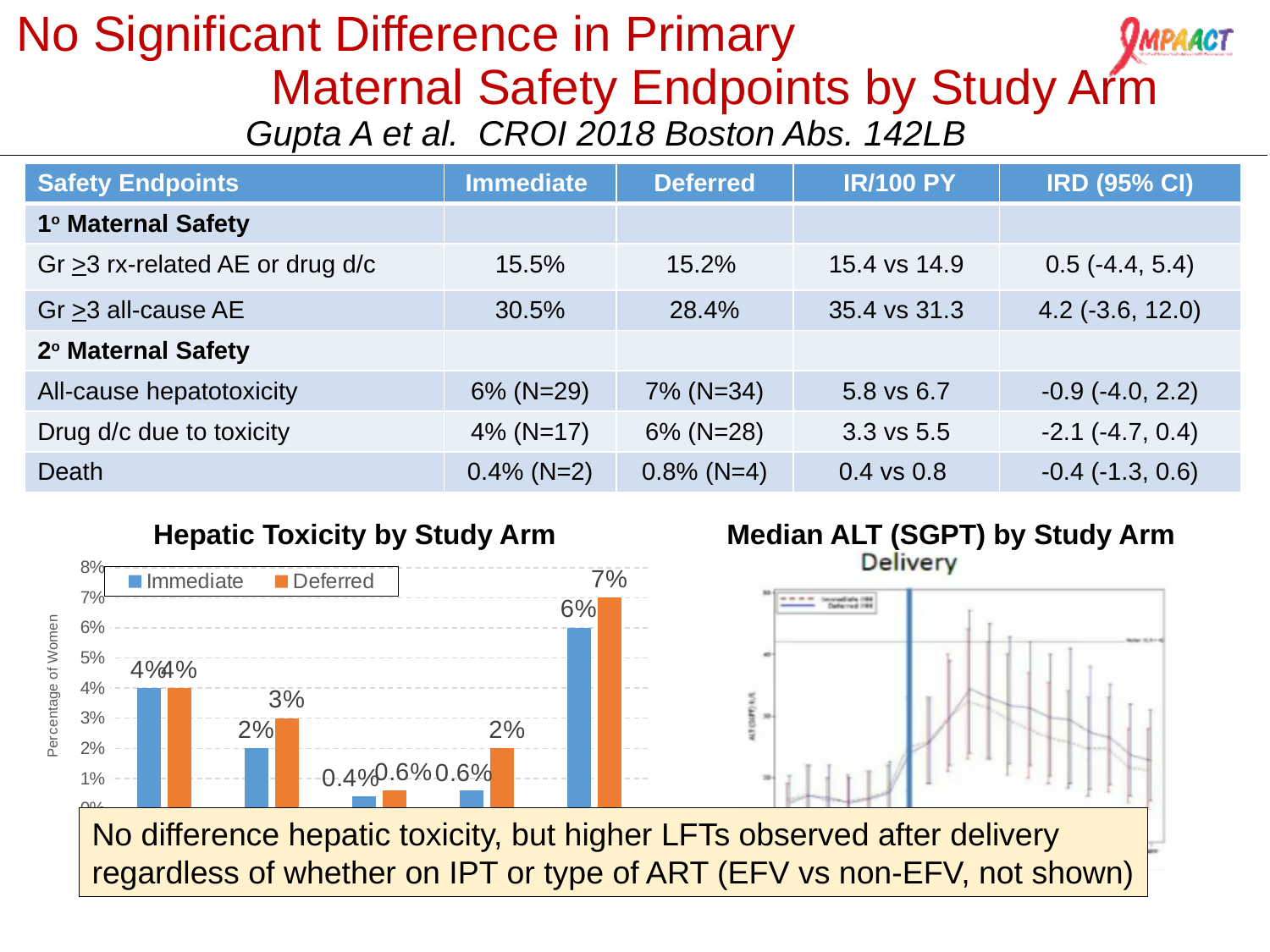
In the Hepatic Toxicity by Study Arm chart, which series has the tallest bar? Deferred In the rightmost group of the Hepatic Toxicity by Study Arm chart, which is larger, Immediate or Deferred? Deferred In the Hepatic Toxicity by Study Arm chart, what is the Deferred value in the rightmost group of bars? 7% What kind of chart is the Hepatic Toxicity by Study Arm chart? bar chart What is the y-axis label of the Hepatic Toxicity by Study Arm chart? Percentage of Women In the Hepatic Toxicity by Study Arm chart, what is the Immediate value in the rightmost group of bars? 6% How many series does the legend of the Hepatic Toxicity by Study Arm chart list? 2 How many groups of bars are plotted in the Hepatic Toxicity by Study Arm chart? 5 What are the two series named in the legend of the Hepatic Toxicity by Study Arm chart? Immediate and Deferred In the Hepatic Toxicity by Study Arm chart, what is the highest value labelled on any bar? 7% In the rightmost group of the Hepatic Toxicity by Study Arm chart, what is the difference between the Deferred and Immediate values? 1% In the Hepatic Toxicity by Study Arm chart, what is the lowest value labelled on any bar? 0.4%